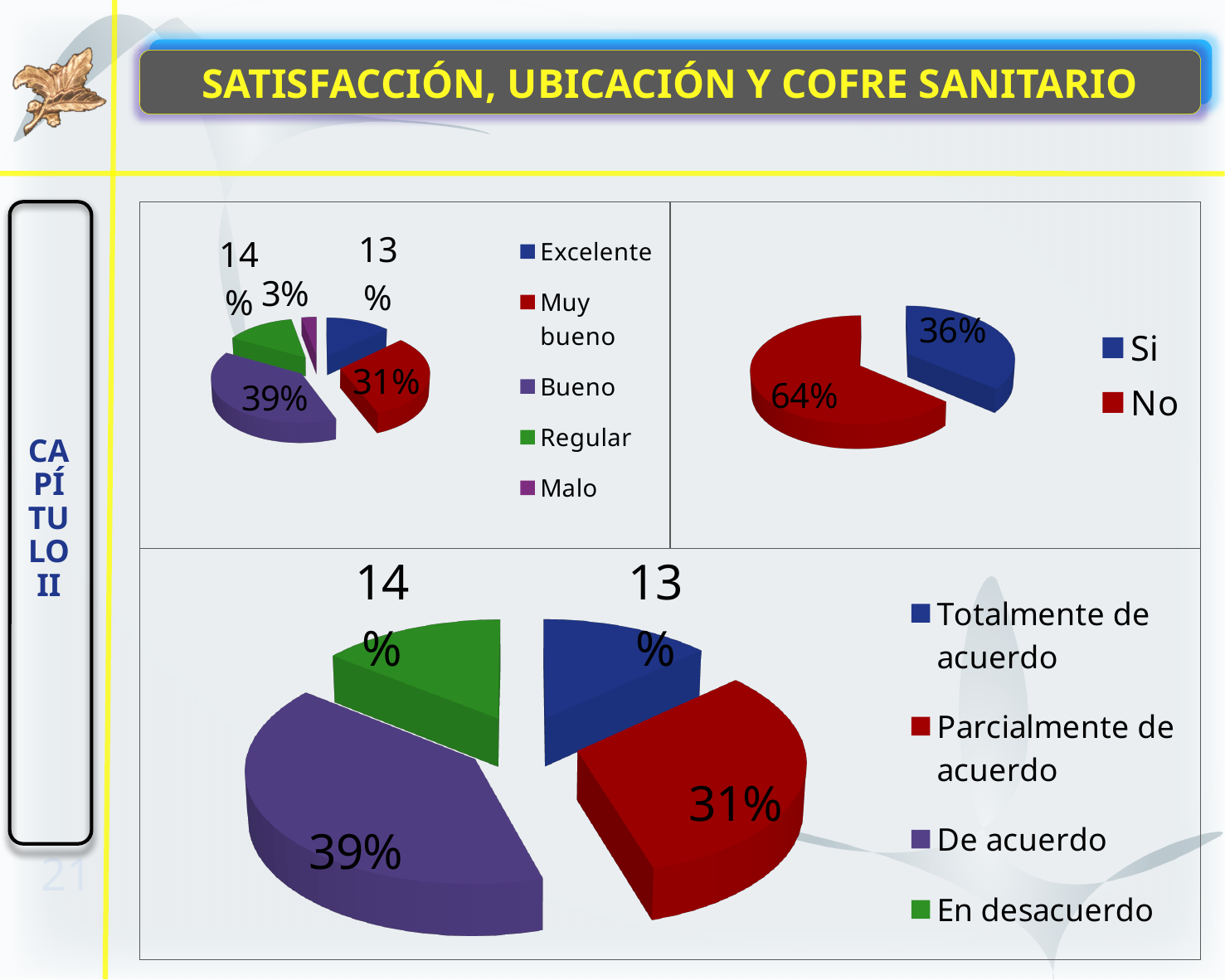
In the bottom pie chart, what is the difference between De acuerdo and Totalmente de acuerdo? 26% In the top-left pie chart, how many categories does the legend list? 5 In the top-right pie chart, what is the difference between the No and Si shares? 28% What type of chart is the bottom chart? Pie chart In the top-right pie chart, which is larger, Si or No? No In the top-right pie chart, what percentage is shown for No? 64% In the top-left pie chart, which category has the smallest share? Malo In the top-left pie chart, which category has the largest share? Bueno In the bottom pie chart, which category has the largest share? De acuerdo In the top-left pie chart, what percentage is shown for Malo? 3% In the bottom pie chart, what percentage is shown for Parcialmente de acuerdo? 31% In the top-left pie chart, what percentage is shown for Bueno? 39%